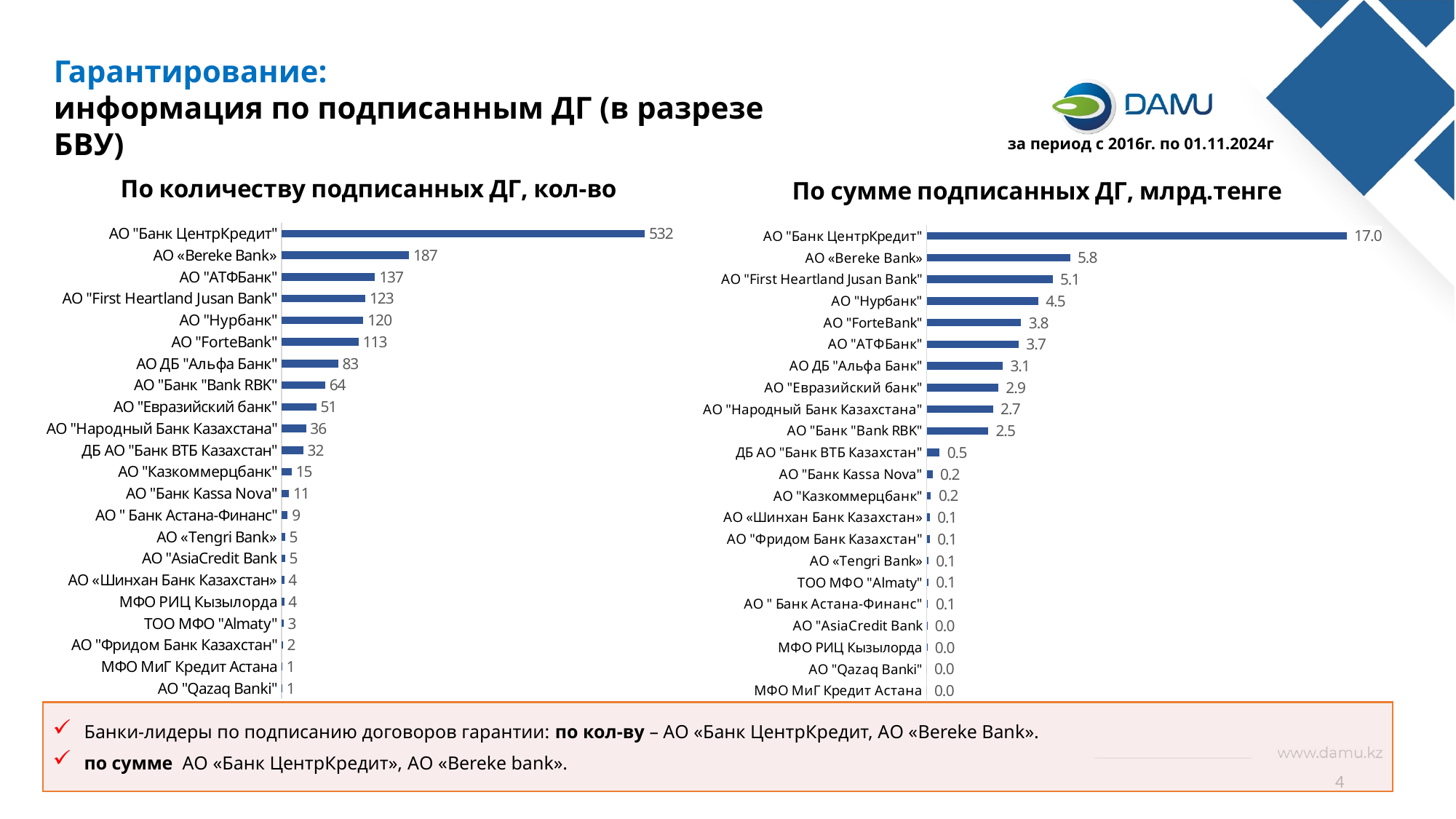
What type of chart is "По сумме подписанных ДГ, млрд.тенге"? Bar chart On the chart "По количеству подписанных ДГ, кол-во", which is larger: АО ДБ "Альфа Банк" or АО "Банк "Bank RBK"? АО ДБ "Альфа Банк" On the chart "По количеству подписанных ДГ, кол-во", what is the difference between АО «Bereke Bank» and АО "АТФБанк"? 50 On the chart "По сумме подписанных ДГ, млрд.тенге", what is the value for АО "Банк "Bank RBK"? 2.5 On the chart "По количеству подписанных ДГ, кол-во", which bank has the highest value? АО "Банк ЦентрКредит" How many banks are listed on the chart "По количеству подписанных ДГ, кол-во"? 22 On the chart "По количеству подписанных ДГ, кол-во", what is the value for АО "Банк ЦентрКредит"? 532 On the chart "По сумме подписанных ДГ, млрд.тенге", which is larger: АО "ForteBank" or АО "АТФБанк"? АО "ForteBank" On the chart "По количеству подписанных ДГ, кол-во", what is the value for АО "Нурбанк"? 120 On the chart "По сумме подписанных ДГ, млрд.тенге", which bank has the highest value? АО "Банк ЦентрКредит" On the chart "По сумме подписанных ДГ, млрд.тенге", what is the value for АО «Bereke Bank»? 5.8 On the chart "По сумме подписанных ДГ, млрд.тенге", what is the difference between АО "Банк ЦентрКредит" and АО «Bereke Bank»? 11.2